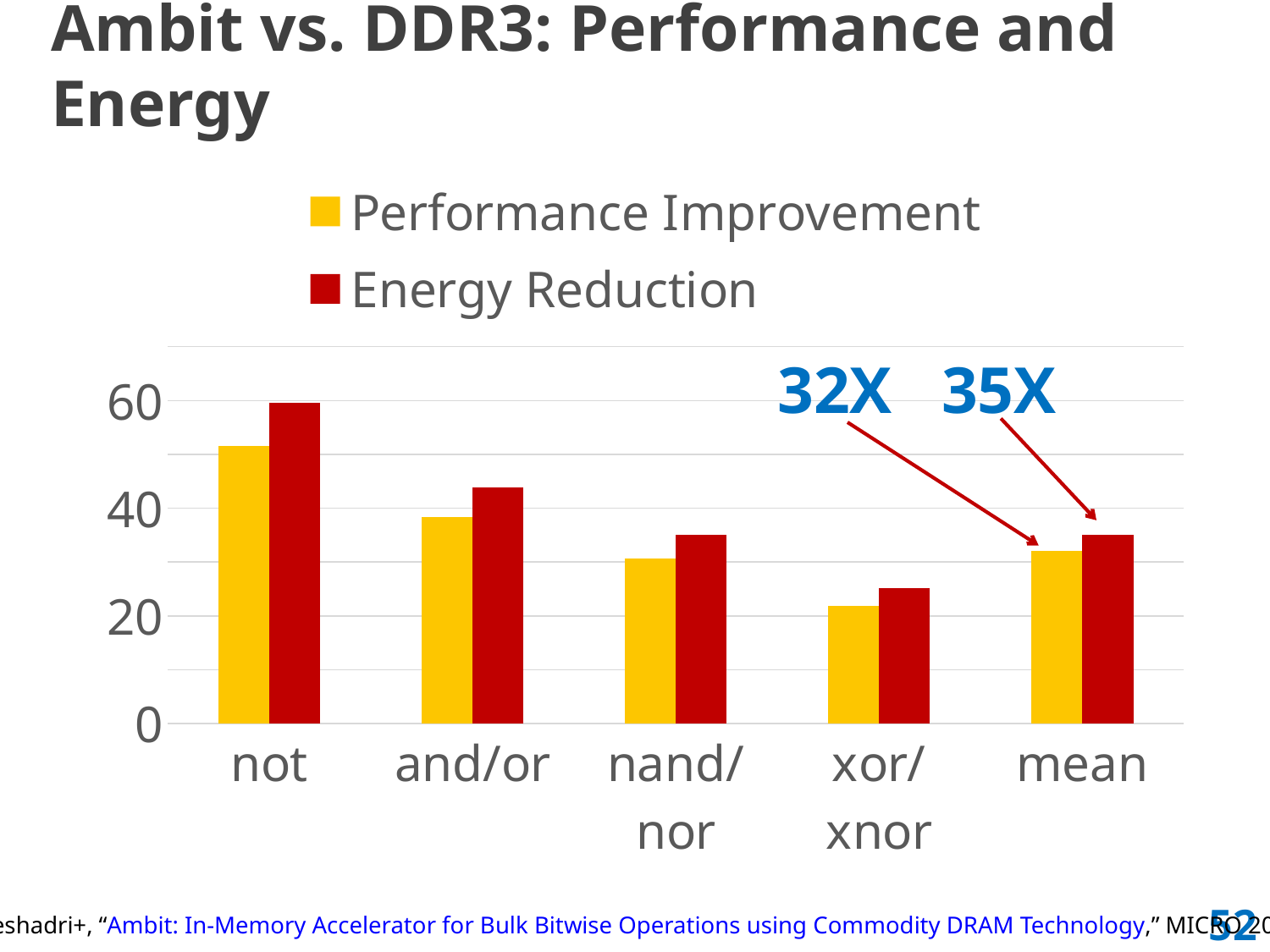
Which category has the lowest Energy Reduction? xor/xnor What kind of chart is shown on the slide? bar chart What is the mean Performance Improvement labelled on the chart? 32X What is the mean Energy Reduction labelled on the chart? 35X How many categories are shown along the x axis? 5 For the 'not' category, which is larger: Performance Improvement or Energy Reduction? Energy Reduction Which category has the highest Performance Improvement? not Is the Performance Improvement for 'not' greater or less than 40? greater How many series does the legend list? 2 What is the difference between the labelled mean Energy Reduction and mean Performance Improvement? 3X What colour represents Energy Reduction in the legend? red Going from 'not' to 'xor/xnor' along the x axis, do the Performance Improvement bars rise or fall? fall